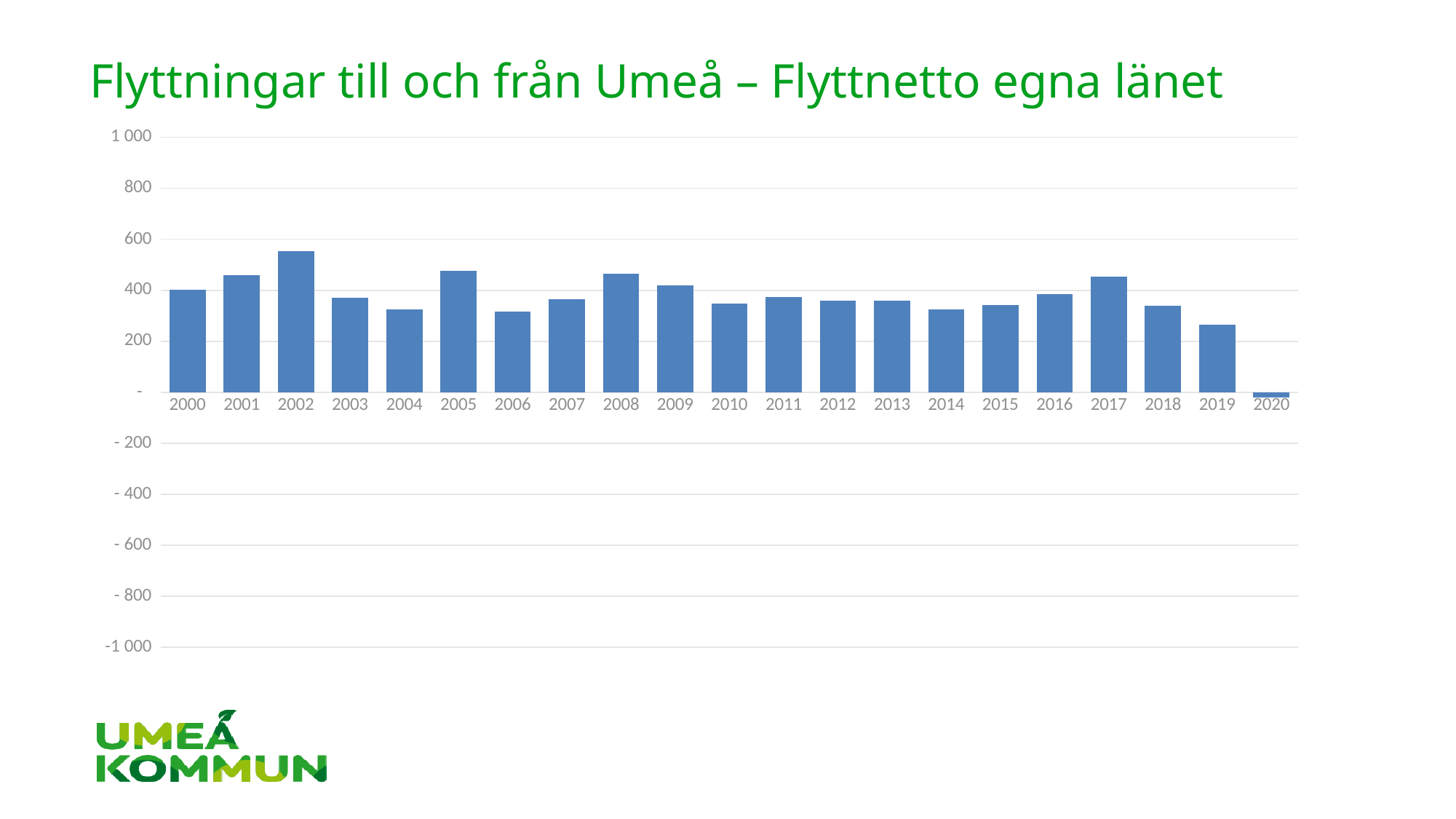
Which year has the lowest value in the chart? 2020 From 2017 to 2020, do the values rise or fall? fall Which year has the larger value, 2002 or 2019? 2002 Is the value for 2017 greater or less than 400? greater Which year has the highest value in the chart? 2002 Is the value for 2002 greater or less than 400? greater How many years are shown on the x axis of the chart? 21 Is the value for 2006 greater or less than 400? less Which year has the larger value, 2005 or 2004? 2005 What kind of chart is shown on the slide? bar chart What is the title of the chart on the slide? Flyttningar till och från Umeå – Flyttnetto egna länet